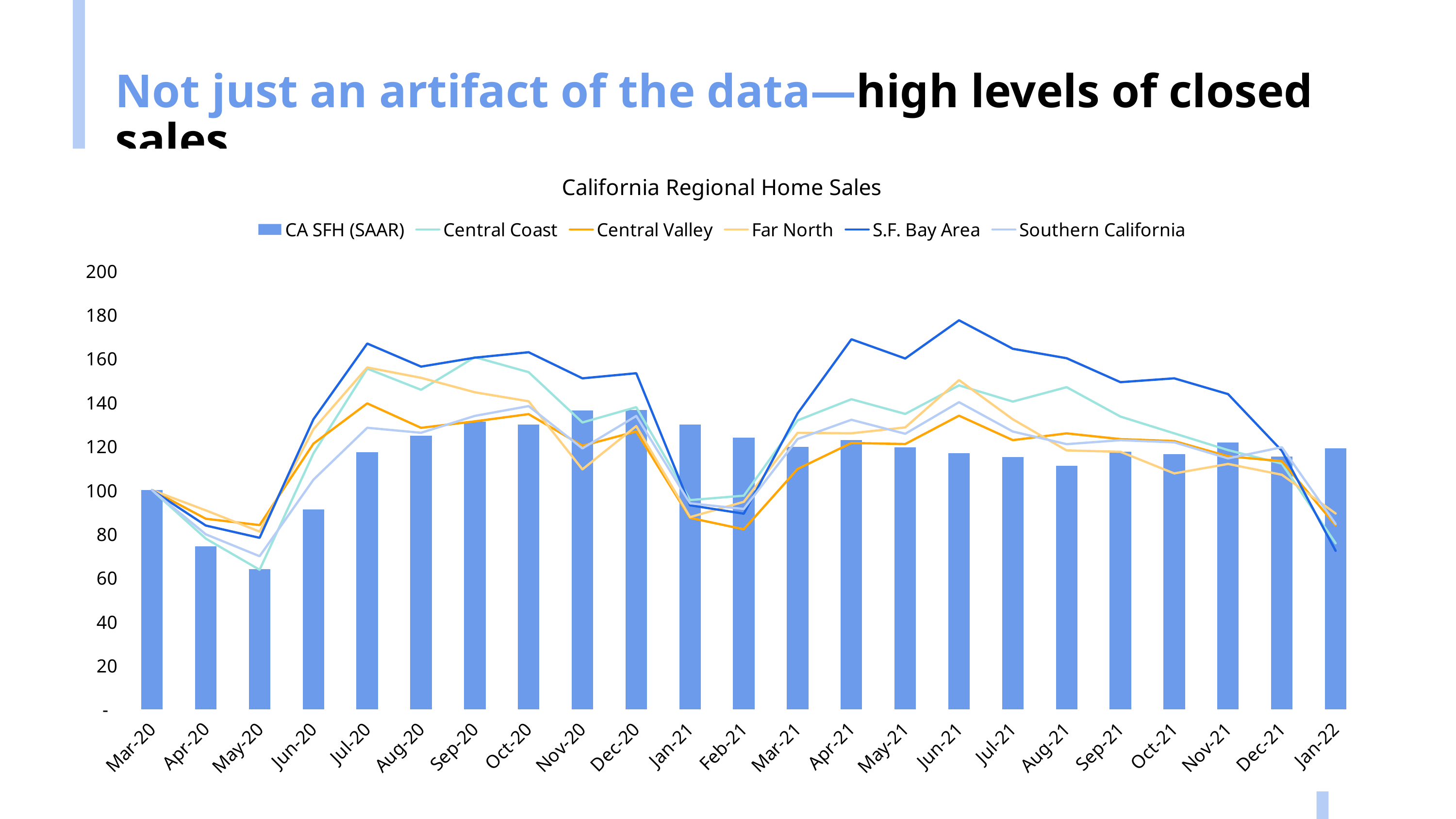
Is the CA SFH (SAAR) bar for Nov-20 greater or less than 120? greater Do the CA SFH (SAAR) bars rise or fall from Mar-20 to May-20? fall What is the title of the chart? California Regional Home Sales Which month has the lowest CA SFH (SAAR) bar? May-20 How many months are shown along the x axis? 23 Is the S.F. Bay Area value for Jun-21 greater or less than 160? greater Is the CA SFH (SAAR) bar for May-20 greater or less than 80? less How many series does the legend list? 6 What kind of chart is shown on the slide? Combination bar and line chart In which month does the S.F. Bay Area line reach its highest point? Jun-21 Which is larger, the CA SFH (SAAR) bar for Apr-20 or for May-20? Apr-20